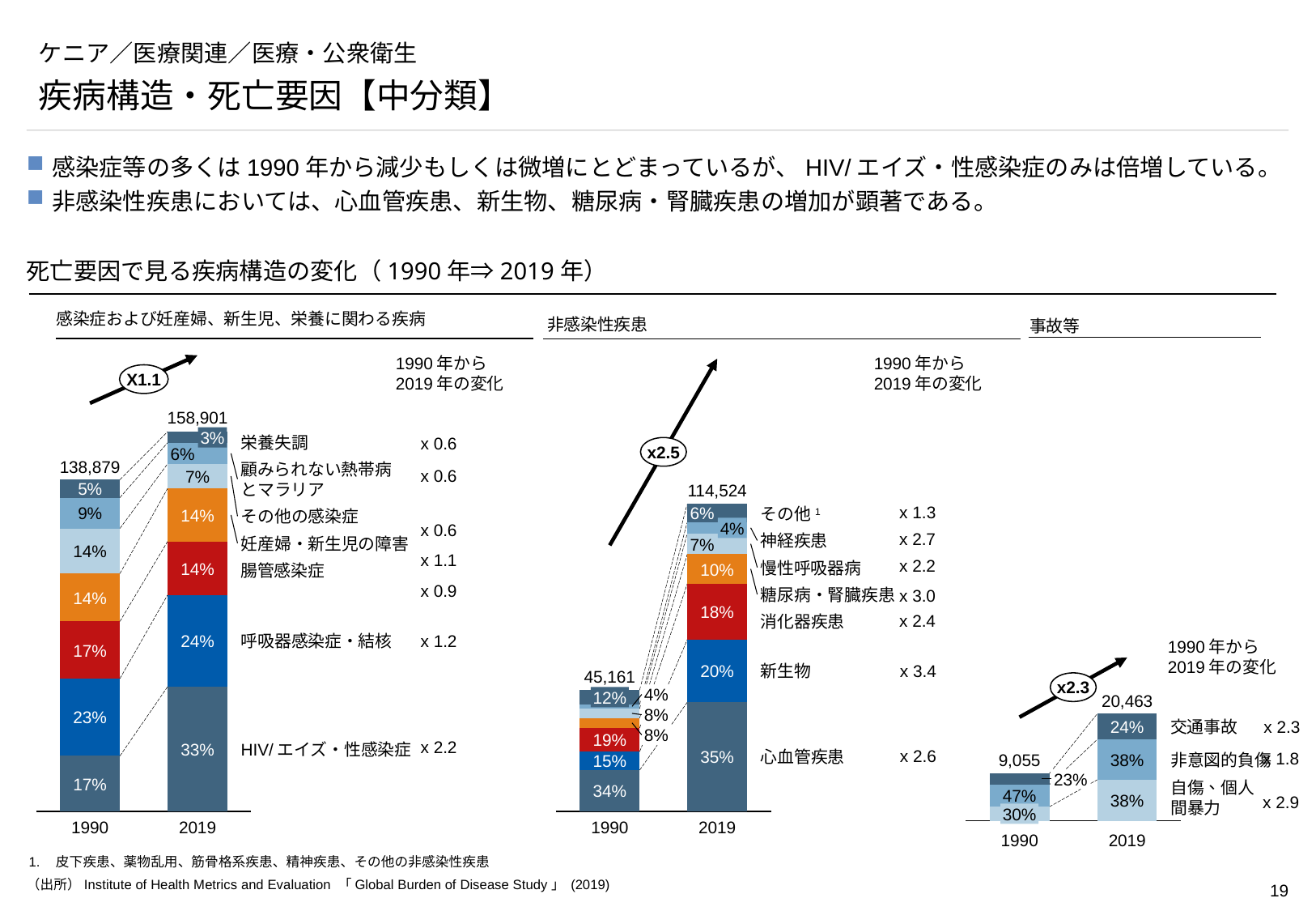
In the 事故等 chart, what percentage does 交通事故 account for in the 2019 bar? 24% In the 事故等 chart, what is the difference between the 2019 total and the 1990 total? 11,408 In the 非感染性疾患 chart, which category has the largest share of the 2019 bar? 心血管疾患 In the 非感染性疾患 chart, what percentage does 新生物 account for in the 2019 bar? 20% In the 非感染性疾患 chart, what multiplier is shown in the circle above the arrow between 1990 and 2019? x2.5 In the 事故等 chart, how many categories make up the 2019 bar? 3 In the 感染症および妊産婦、新生児、栄養に関わる疾病 chart, what is the total value shown above the 2019 bar? 158,901 In the 非感染性疾患 chart, what is the total value shown above the 2019 bar? 114,524 What kind of chart is the 事故等 chart? Stacked bar chart In the 感染症および妊産婦、新生児、栄養に関わる疾病 chart, what percentage does HIV/エイズ・性感染症 account for in the 2019 bar? 33% In the 感染症および妊産婦、新生児、栄養に関わる疾病 chart, which is larger: the 1990 total or the 2019 total? 2019 total In the 非感染性疾患 chart, what is the total value shown above the 1990 bar? 45,161